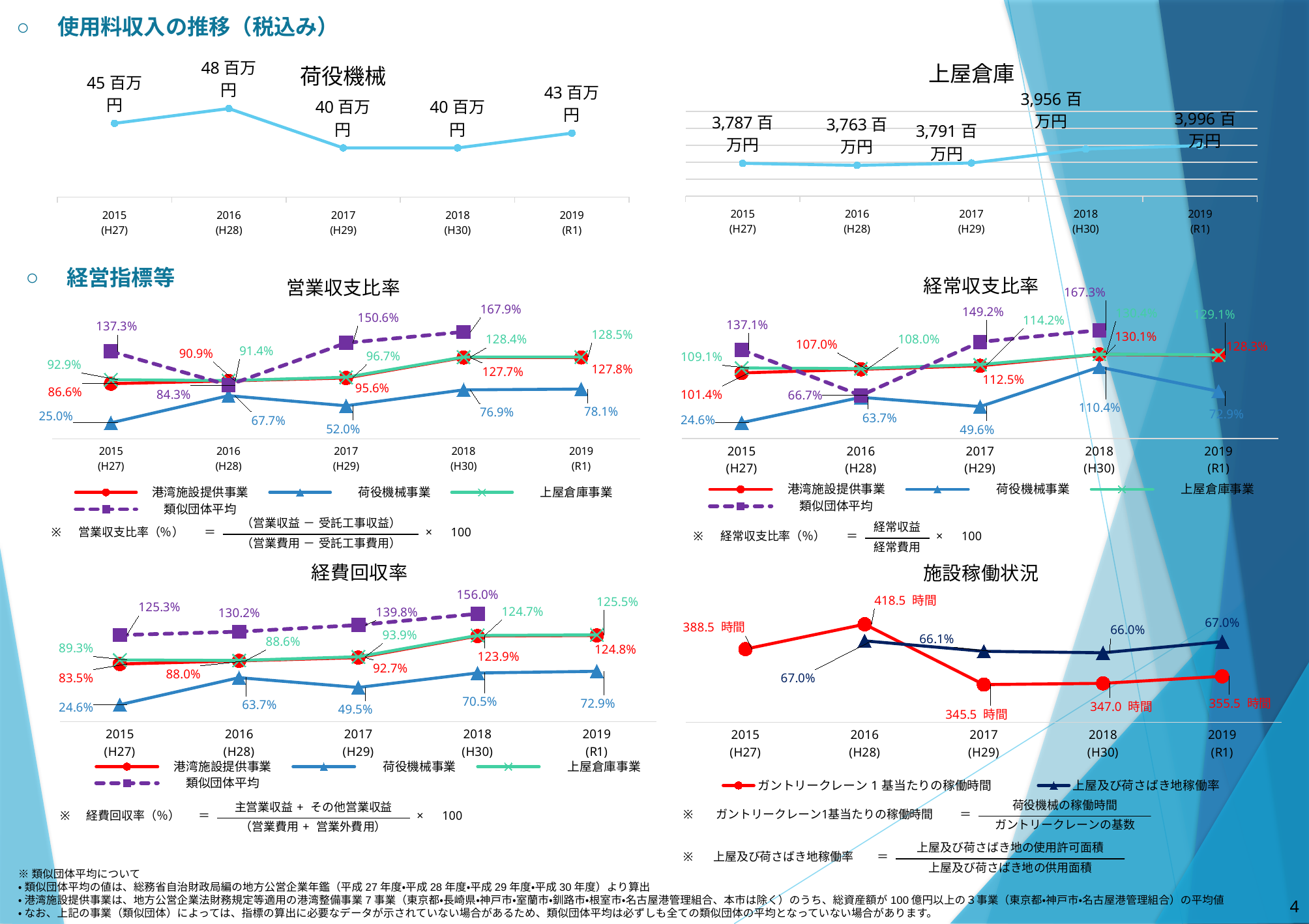
In the 経費回収率 chart, how many series does the legend list? 4 In the 経費回収率 chart, what is the value of 上屋倉庫事業 for 2019 (R1)? 125.5% In the 営業収支比率 chart, what is the difference between the 荷役機械事業 values for 2019 (R1) and 2015 (H27)? 53.1% What kind of chart is the 施設稼働状況 chart? line chart In the 上屋倉庫 chart, which year has the lowest value? 2016 (H28) In the 上屋倉庫 chart, what is the value for 2019 (R1)? 3,996 百万円 In the 経常収支比率 chart, which is larger for 2016 (H28): 港湾施設提供事業 or 類似団体平均? 港湾施設提供事業 In the 荷役機械 chart, which year has the highest value? 2016 (H28) In the 施設稼働状況 chart, what is the value of ガントリークレーン１基当たりの稼働時間 for 2017 (H29)? 345.5 時間 In the 経常収支比率 chart, what is the value of 荷役機械事業 for 2018 (H30)? 110.4% In the 営業収支比率 chart, what is the value of 類似団体平均 for 2018 (H30)? 167.9% In the 荷役機械 chart, what is the value for 2016 (H28)? 48 百万円